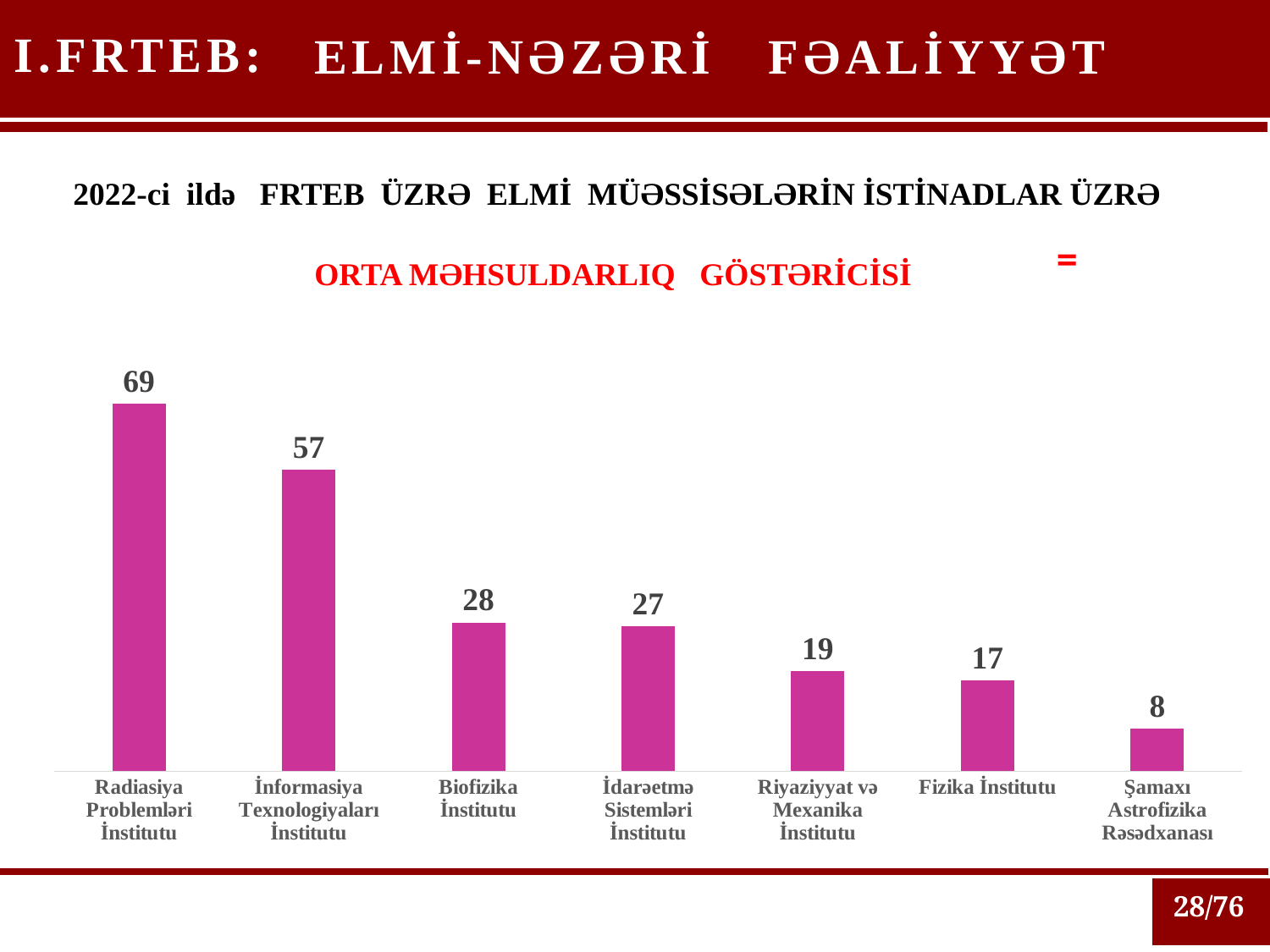
Which is larger, the value for İnformasiya Texnologiyaları İnstitutu or the value for İdarəetmə Sistemləri İnstitutu? İnformasiya Texnologiyaları İnstitutu What kind of chart is shown on the slide? Bar chart What is the value for Radiasiya Problemləri İnstitutu? 69 What is the difference between the values for Radiasiya Problemləri İnstitutu and İnformasiya Texnologiyaları İnstitutu? 12 How many institutions are shown in the chart? 7 What is the difference between the values for Riyaziyyat və Mexanika İnstitutu and Şamaxı Astrofizika Rəsədxanası? 11 Which institution has the highest value? Radiasiya Problemləri İnstitutu Which institution has the lowest value? Şamaxı Astrofizika Rəsədxanası What is the value for Biofizika İnstitutu? 28 Do the values rise or fall from left to right across the chart? Fall What is the value for Şamaxı Astrofizika Rəsədxanası? 8 What is the value for Fizika İnstitutu? 17